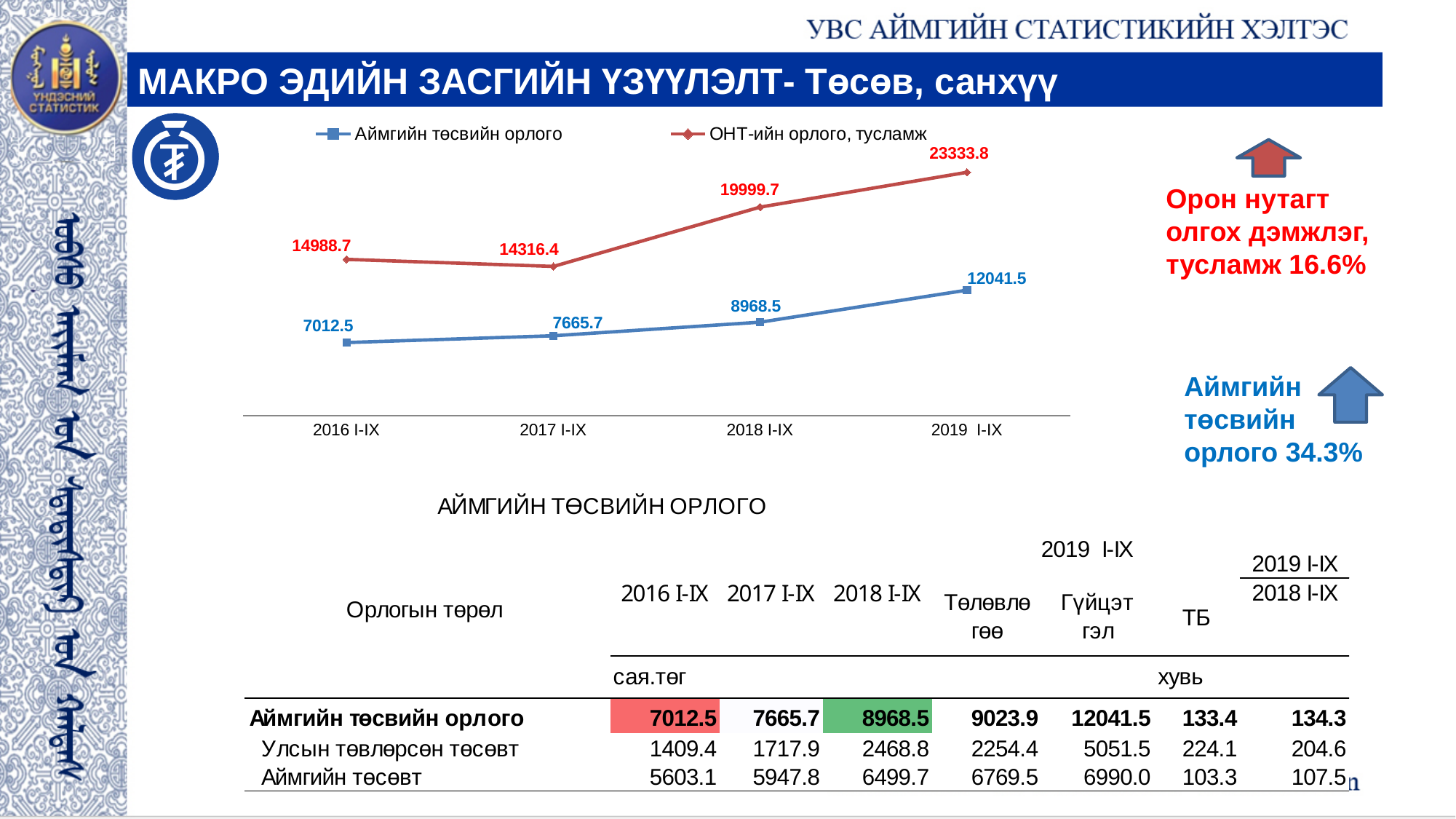
Which series has the larger value in 2016 I-IX, Аймгийн төсвийн орлого or ОНТ-ийн орлого, тусламж? ОНТ-ийн орлого, тусламж What is the difference between ОНТ-ийн орлого, тусламж and Аймгийн төсвийн орлого in 2018 I-IX? 11031.2 What is the value of ОНТ-ийн орлого, тусламж for 2017 I-IX? 14316.4 In which period is ОНТ-ийн орлого, тусламж lowest? 2017 I-IX What is the value of Аймгийн төсвийн орлого for 2016 I-IX? 7012.5 What colour is the line for ОНТ-ийн орлого, тусламж? Red Does Аймгийн төсвийн орлого rise or fall from 2016 I-IX to 2019 I-IX? Rise How many periods are plotted along the x axis of the chart? 4 What kind of chart is shown on the slide? Line chart What is the value of Аймгийн төсвийн орлого for 2019 I-IX? 12041.5 In which period is ОНТ-ийн орлого, тусламж highest? 2019 I-IX How many series does the chart legend list? 2